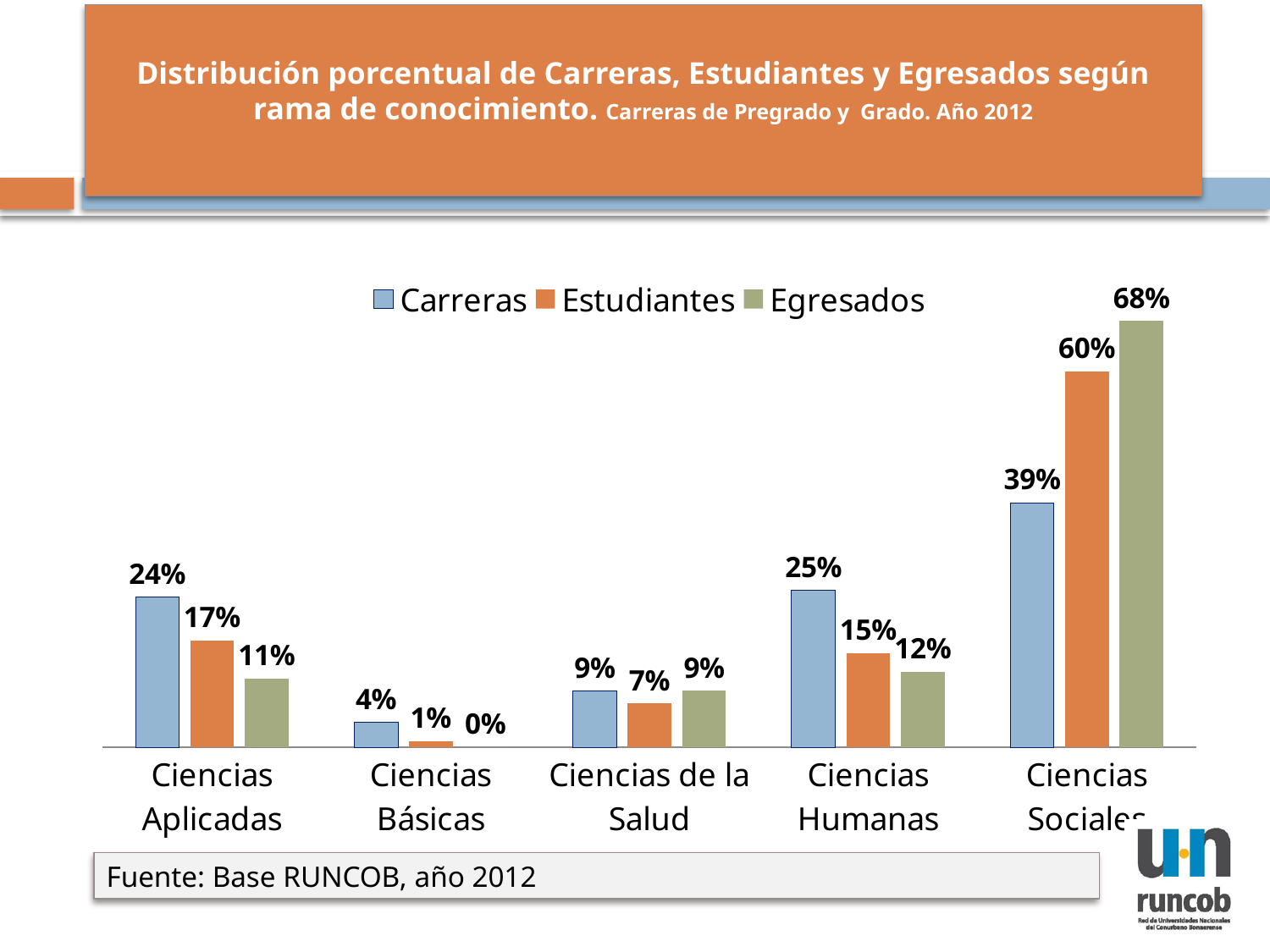
What is the Egresados value for Ciencias Básicas? 0% Which category has the highest Estudiantes value? Ciencias Sociales What is the Carreras value for Ciencias Aplicadas? 24% How many series does the legend list? 3 Which category has the lowest Carreras value? Ciencias Básicas What is the Estudiantes value for Ciencias Humanas? 15% How many categories are shown on the x axis? 5 What is the difference between the Estudiantes and Carreras values for Ciencias Sociales? 21% Which series is shown in orange in the legend? Estudiantes Which is larger for Ciencias Aplicadas: the Carreras value or the Egresados value? Carreras What kind of chart is shown on the slide? Bar chart What is the Egresados value for Ciencias Sociales? 68%